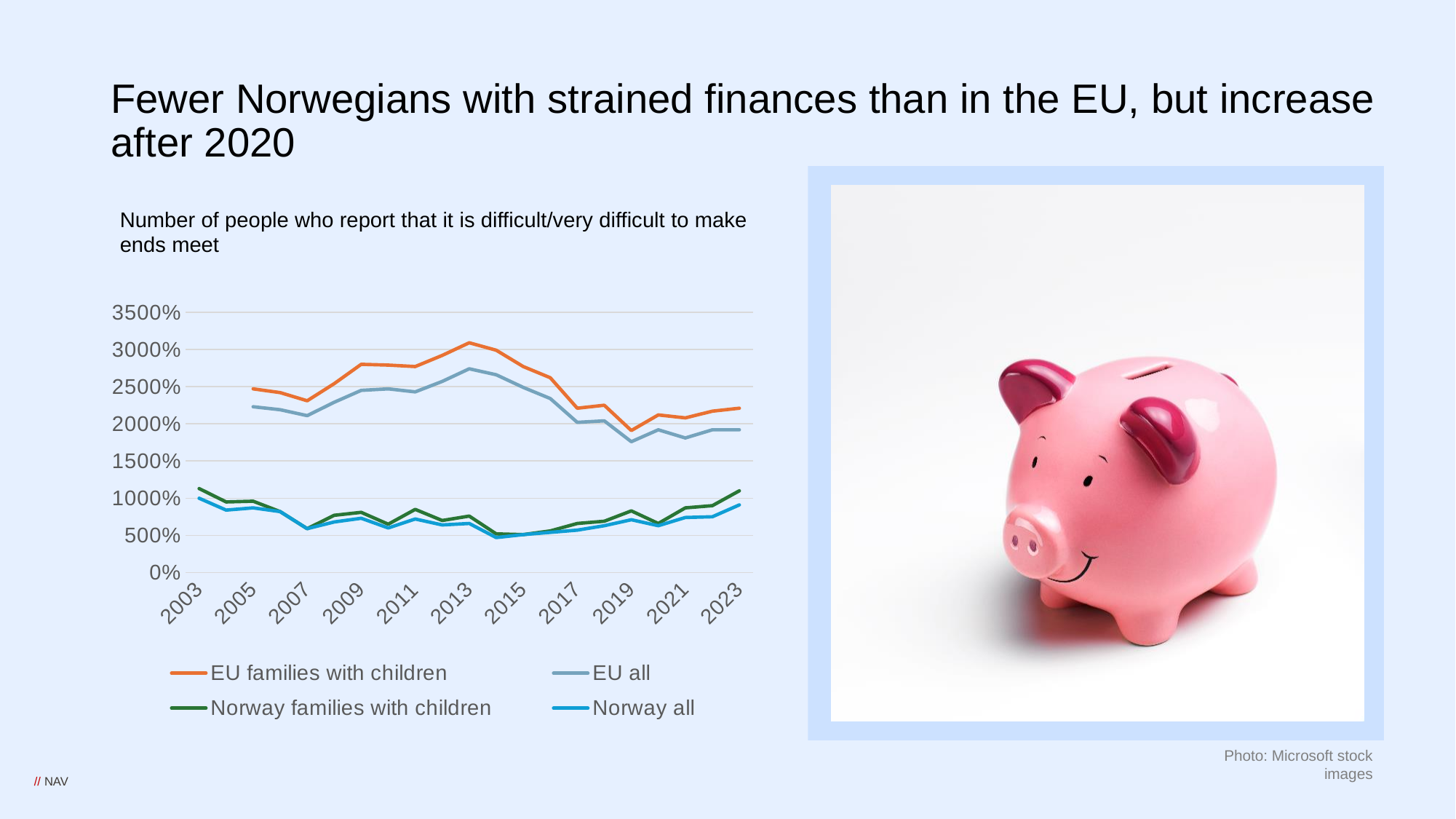
Which series has the lowest value in 2023? Norway all Which series has the highest values across the whole chart? EU families with children In which year does the EU families with children series reach its highest value? 2013 Is the value for Norway all in 2007 greater or less than 1000%? less Is the value for Norway families with children in 2003 greater or less than 1500%? less Does the Norway families with children series rise or fall between 2019 and 2023? rise How many series does the chart's legend list? 4 In 2023, which is larger: EU all or Norway all? EU all Which colour is used for the EU families with children series? orange Is the value for EU families with children in 2013 greater or less than 2500%? greater What kind of chart is shown on the slide? line chart In 2013, which is larger: EU families with children or EU all? EU families with children